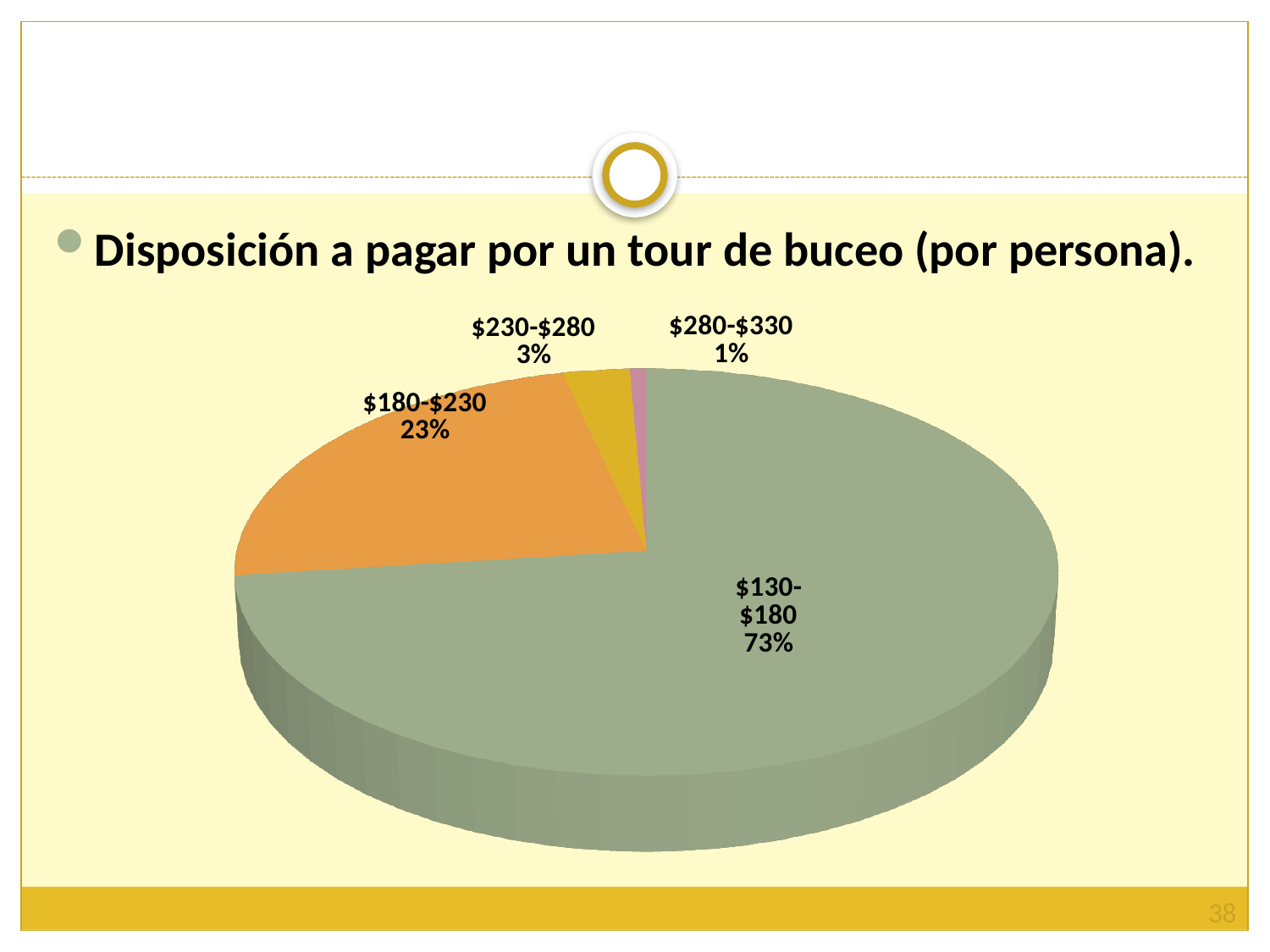
What is the difference in percentage points between the $130-$180 slice and the $180-$230 slice? 50 Which price range has the smallest slice of the pie? $280-$330 What share of the pie does the $280-$330 slice represent? 1% What colour is the $180-$230 slice of the pie? orange Which slice is larger, $230-$280 or $280-$330? $230-$280 How many slices does the pie chart have? 4 Which price range has the largest slice of the pie? $130-$180 What kind of chart is shown on the slide? pie chart What share of the pie does the $230-$280 slice represent? 3% What share of the pie does the $180-$230 slice represent? 23% What is the difference in percentage points between the $180-$230 slice and the $230-$280 slice? 20